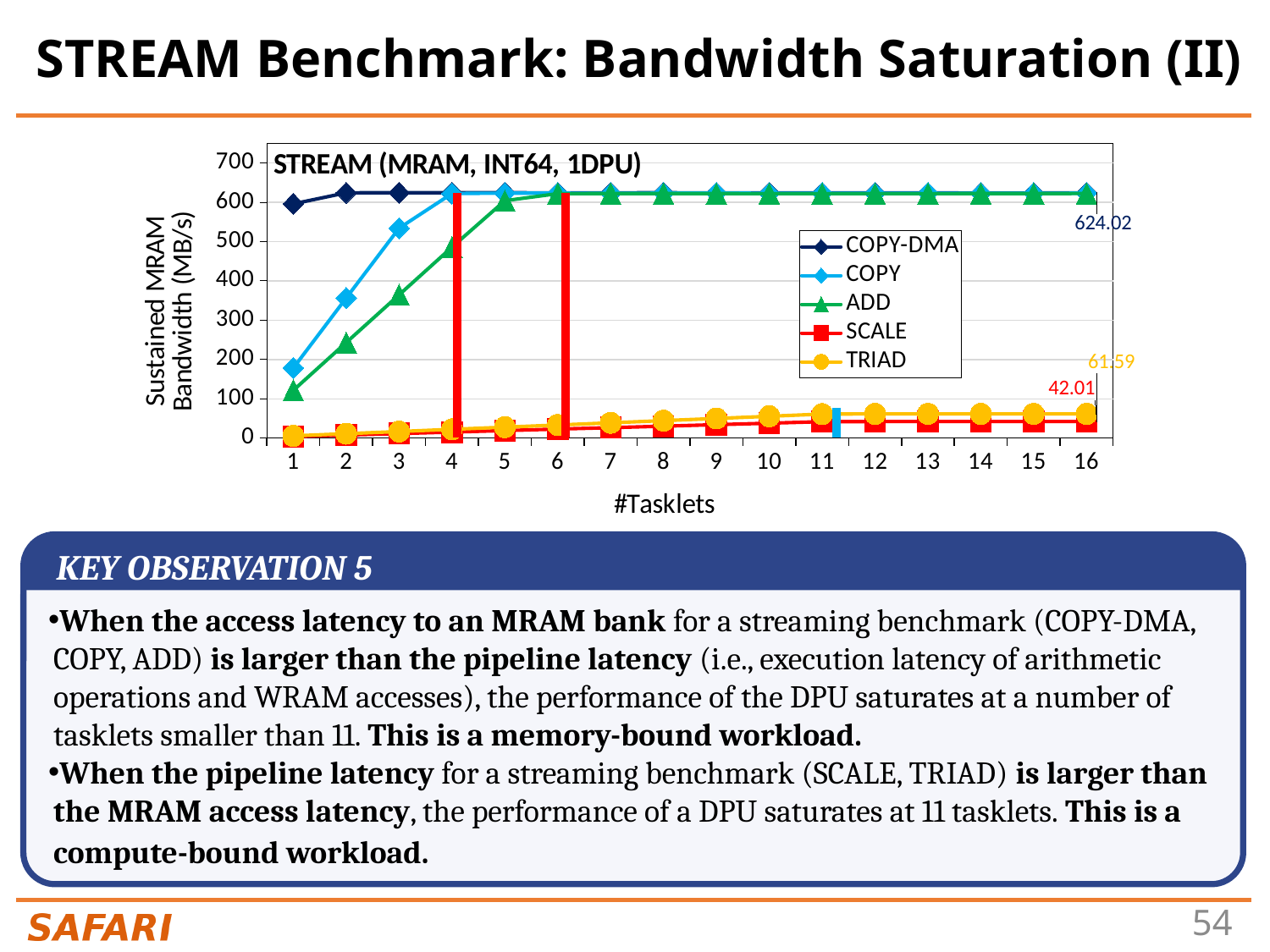
Is the value for COPY at 1 tasklet greater or less than 200? less What kind of chart is shown on the slide? line chart What is the difference between the labelled TRIAD value (61.59) and the labelled SCALE value (42.01) at 16 tasklets? 19.58 What is the data label shown for SCALE at 16 tasklets? 42.01 Is the value for ADD at 4 tasklets greater or less than 500? less How many tasklet counts are plotted along the x axis? 16 What is the title of the chart? STREAM (MRAM, INT64, 1DPU) What is the data label shown for TRIAD at 16 tasklets? 61.59 How many series does the chart legend list? 5 At 16 tasklets, which series has the larger value, TRIAD or SCALE? TRIAD Which series has the highest sustained bandwidth at 1 tasklet? COPY-DMA What is the data label shown near the top right of the chart for the saturated bandwidth? 624.02